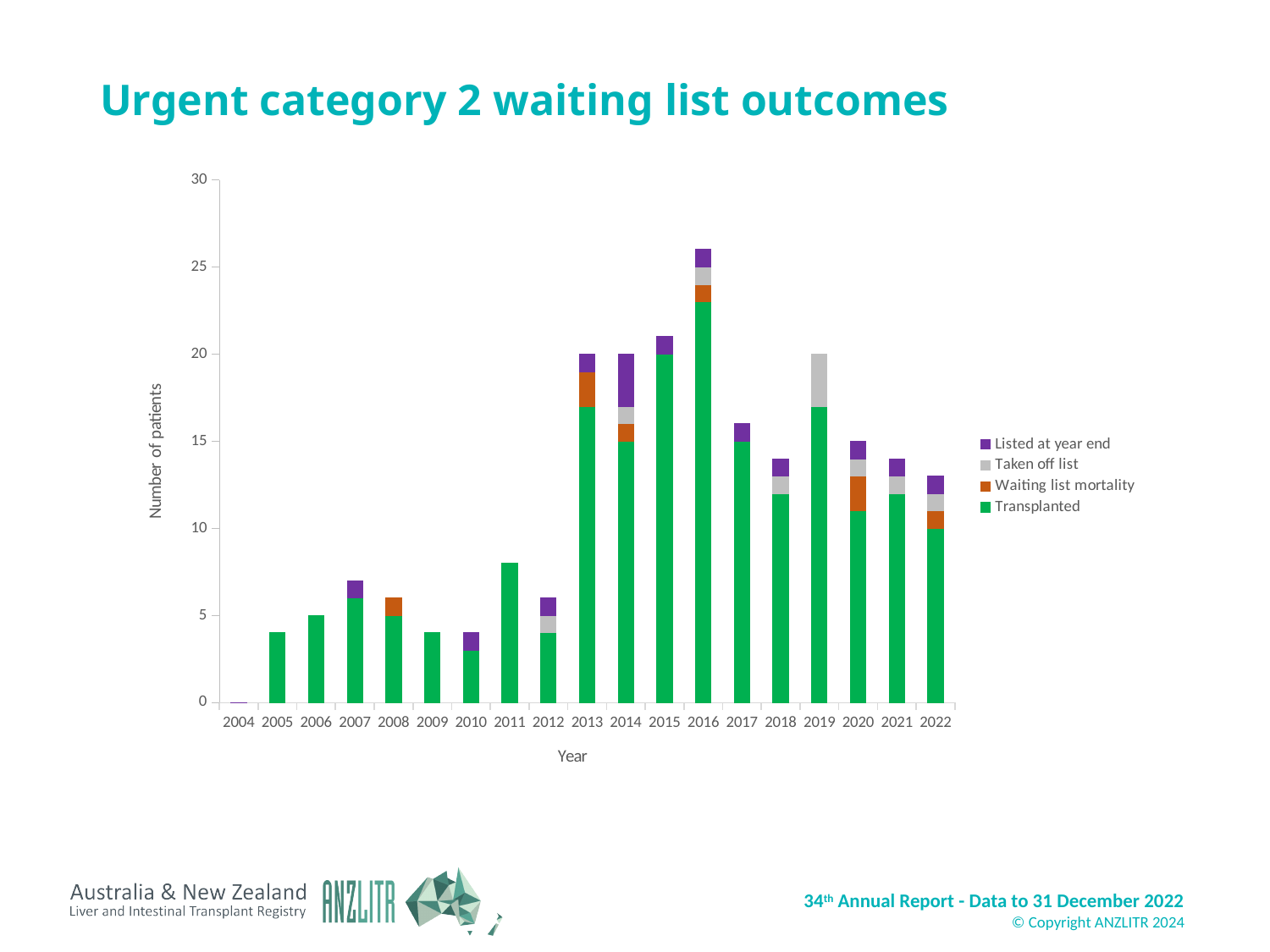
Which year has the highest total number of patients? 2016 What is the label on the y axis? Number of patients What is the total number of patients for 2020? 15 Do the total values rise or fall from 2016 to 2018? fall How many series does the legend list? 4 How many years are shown on the x axis? 19 Is the total number of patients for 2018 greater or less than 15? less Which year has the lowest total number of patients? 2004 Is the total number of patients for 2016 greater or less than 25? greater What kind of chart is shown on the slide? Stacked bar chart Is the total number of patients for 2011 greater or less than 5? greater Which year has a larger total number of patients, 2015 or 2017? 2015